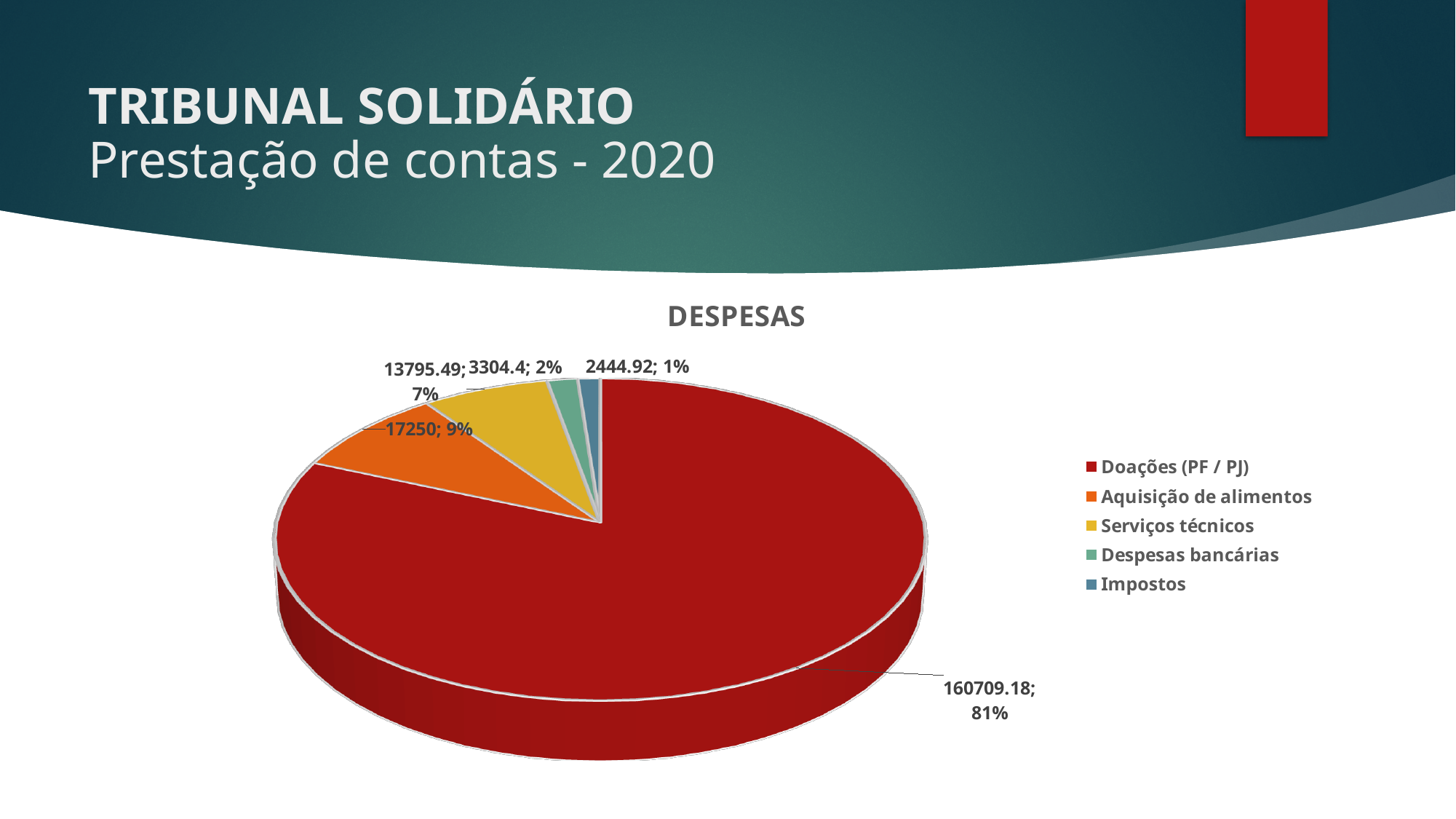
What is the value for Doações (PF / PJ)? 160709.18 What is the value for Aquisição de alimentos? 17250 What is the title of the chart? DESPESAS What is the value for Despesas bancárias? 3304.4 What share of the pie does Doações (PF / PJ) represent? 81% Which category has the smallest slice? Impostos What share of the pie does Serviços técnicos represent? 7% What is the value for Serviços técnicos? 13795.49 How many categories does the legend list? 5 Which category has the largest slice? Doações (PF / PJ) What is the value for Impostos? 2444.92 What kind of chart is shown on the slide? Pie chart